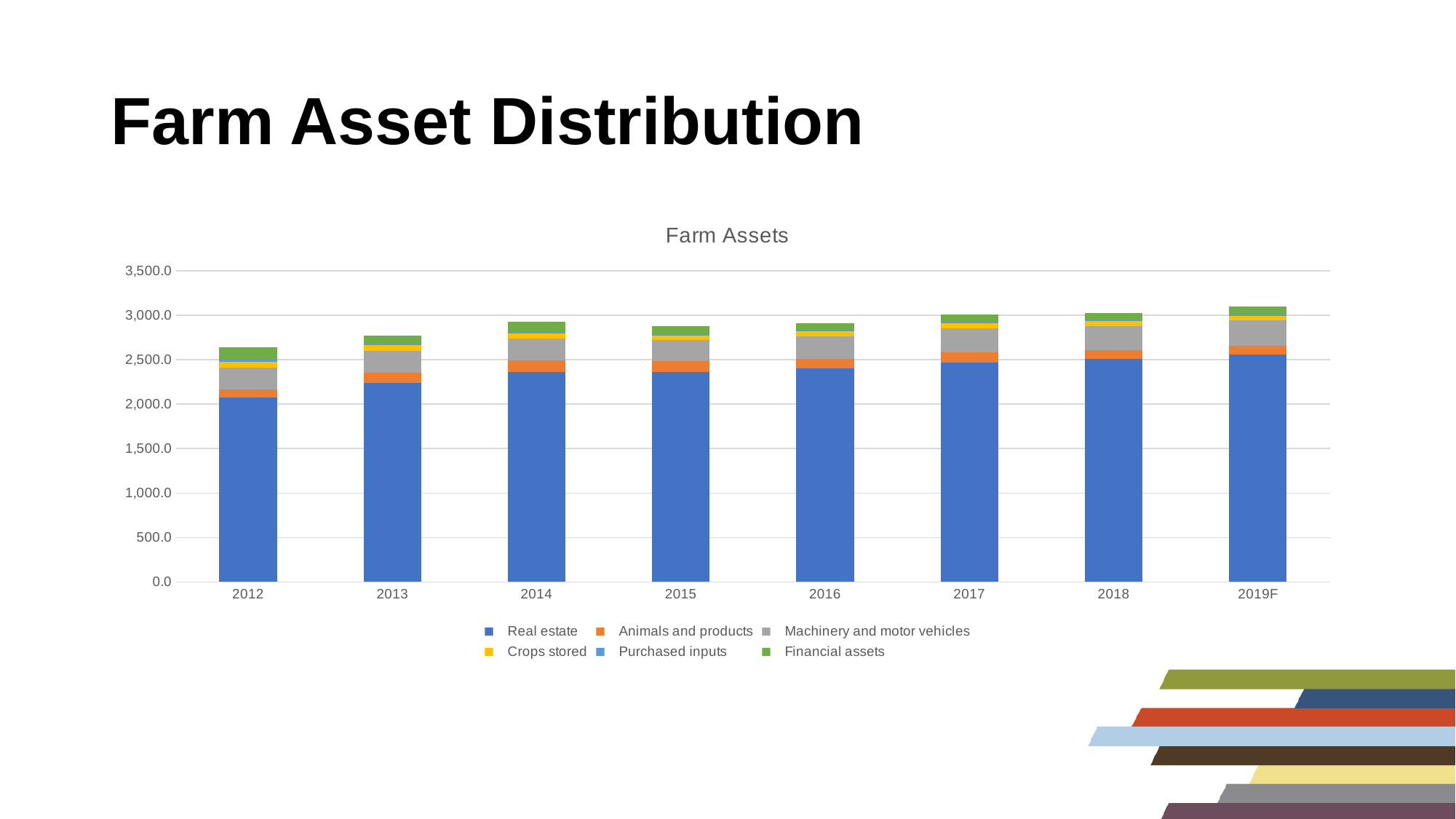
What kind of chart is shown on the slide? Stacked bar chart How many years are shown on the x axis of the Farm Assets chart? 8 Do the total farm assets generally rise or fall from 2012 to 2019F? Rise How many series does the legend of the Farm Assets chart list? 6 Is the total bar for 2015 greater or less than 3,000? less Is the Real estate value for 2012 greater or less than 2,000? greater Which year has the shortest total bar in the Farm Assets chart? 2012 Which series is shown in blue at the bottom of each bar in the Farm Assets chart? Real estate Which year has the tallest total bar in the Farm Assets chart? 2019F Is the total bar for 2012 greater or less than 2,500? greater Which is larger, the Real estate value for 2012 or for 2018? 2018